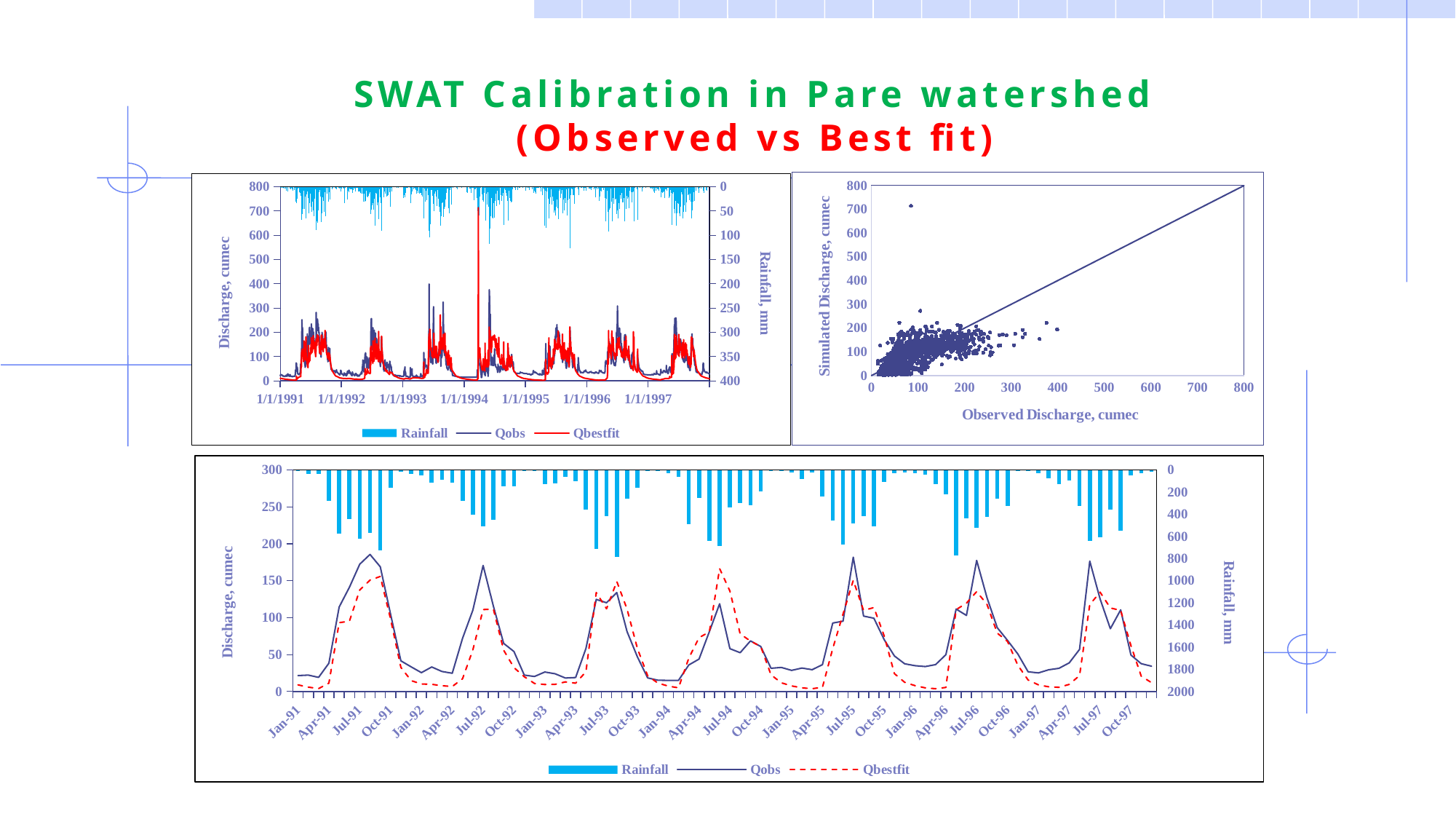
In the bottom chart, is the Qobs value at Jul-91 greater or less than 150? greater In the top-right chart, is the highest plotted point's simulated discharge greater or less than 600? greater In the bottom chart, what are the three legend entries? Rainfall, Qobs, Qbestfit In the bottom chart, is the Qobs value at Jan-92 greater or less than 50? less In the top-right chart, what is the title of the x axis? Observed Discharge, cumec In the bottom chart, how many series does the legend list? 3 What kind of chart is the top-right chart (Simulated Discharge vs Observed Discharge)? scatter chart In the top-left chart, how many series does the legend list? 3